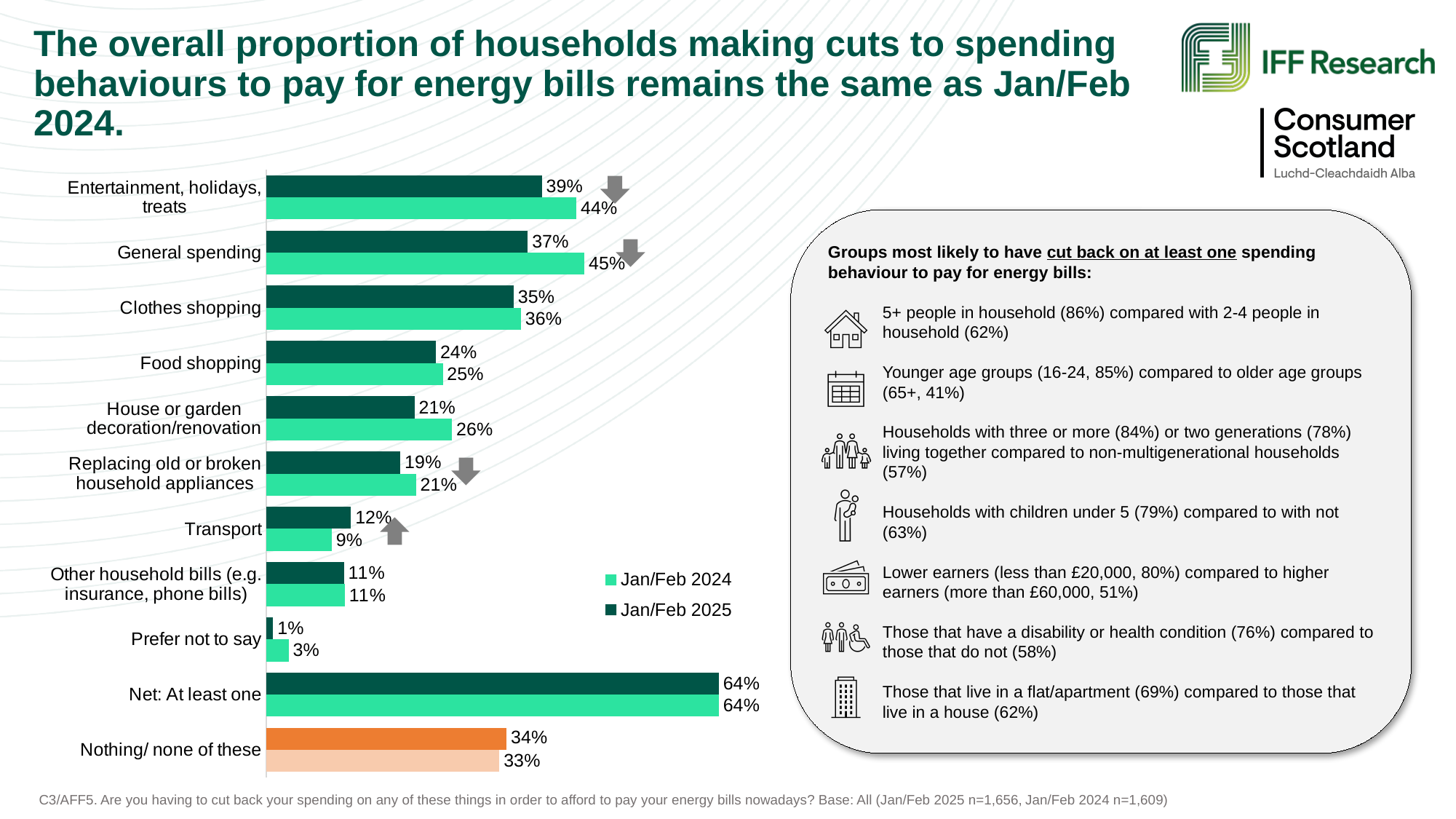
How many series does the legend list? 2 What is the Jan/Feb 2025 value for General spending? 37% Excluding the Net and Nothing rows, which spending category has the highest Jan/Feb 2024 value? General spending Which category has the lowest Jan/Feb 2025 value? Prefer not to say What is the difference between the Jan/Feb 2024 and Jan/Feb 2025 values for General spending? 8 percentage points What is the Jan/Feb 2024 value for Entertainment, holidays, treats? 44% For Transport, which is larger: the Jan/Feb 2024 value or the Jan/Feb 2025 value? Jan/Feb 2025 What is the Jan/Feb 2025 value for Transport? 12% What is the Jan/Feb 2024 value for Prefer not to say? 3% What is the Net: At least one value for Jan/Feb 2025? 64% How many categories are shown on the chart's vertical axis? 11 What kind of chart is shown on the slide? bar chart